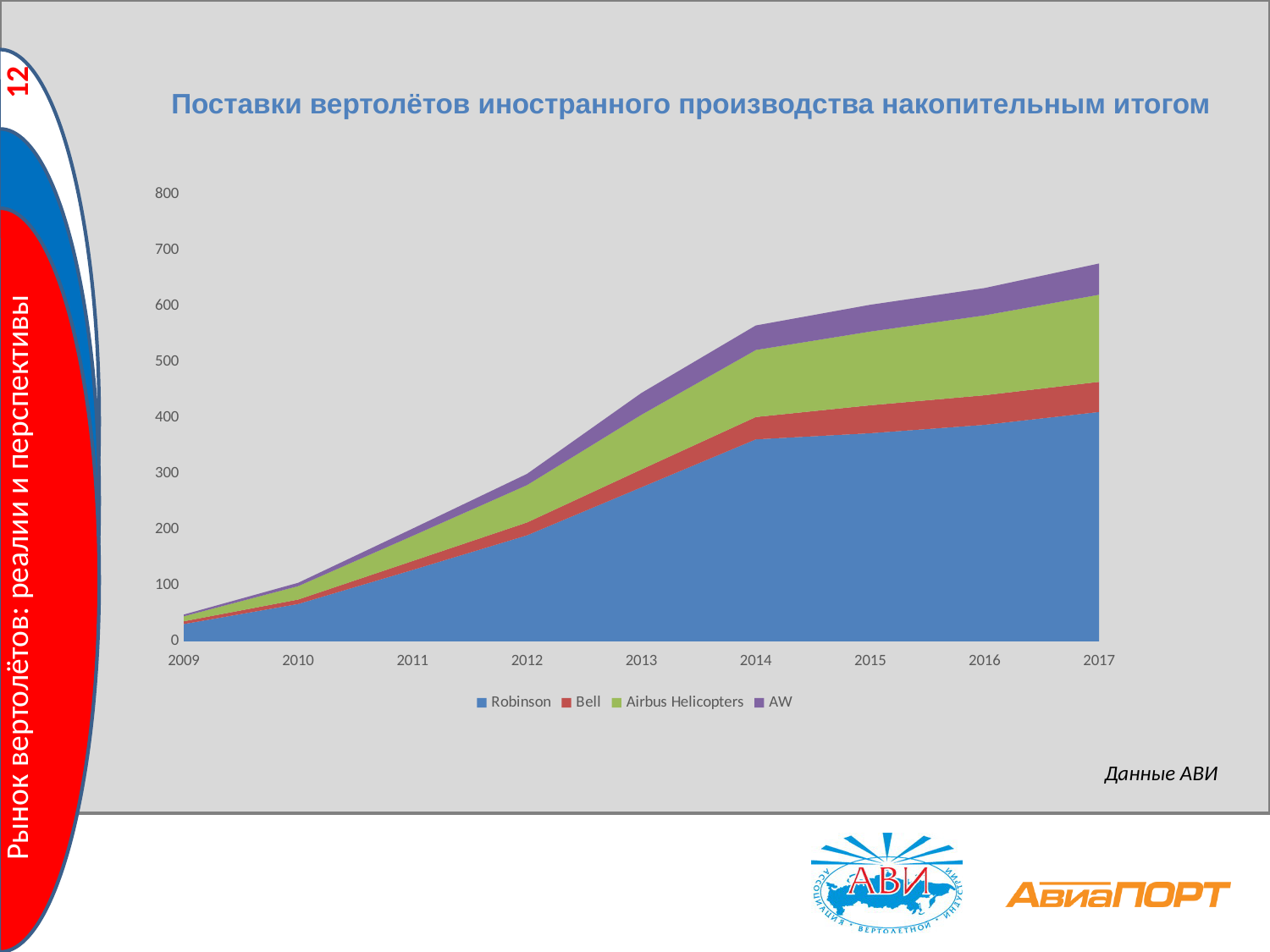
How many series does the legend list? 4 Is the total stacked value for 2017 greater or less than 600? greater What kind of chart is shown on the slide? Stacked area chart Is the total stacked value for 2014 greater or less than 500? greater What is the title of the chart? Поставки вертолётов иностранного производства накопительным итогом Do the cumulative totals rise or fall from 2009 to 2017? Rise In which year is the total stacked value lowest? 2009 In which year is the total stacked value highest? 2017 Which series is shown at the bottom of the stack (blue)? Robinson How many years are shown along the x axis? 9 Is the total stacked value for 2009 greater or less than 100? less